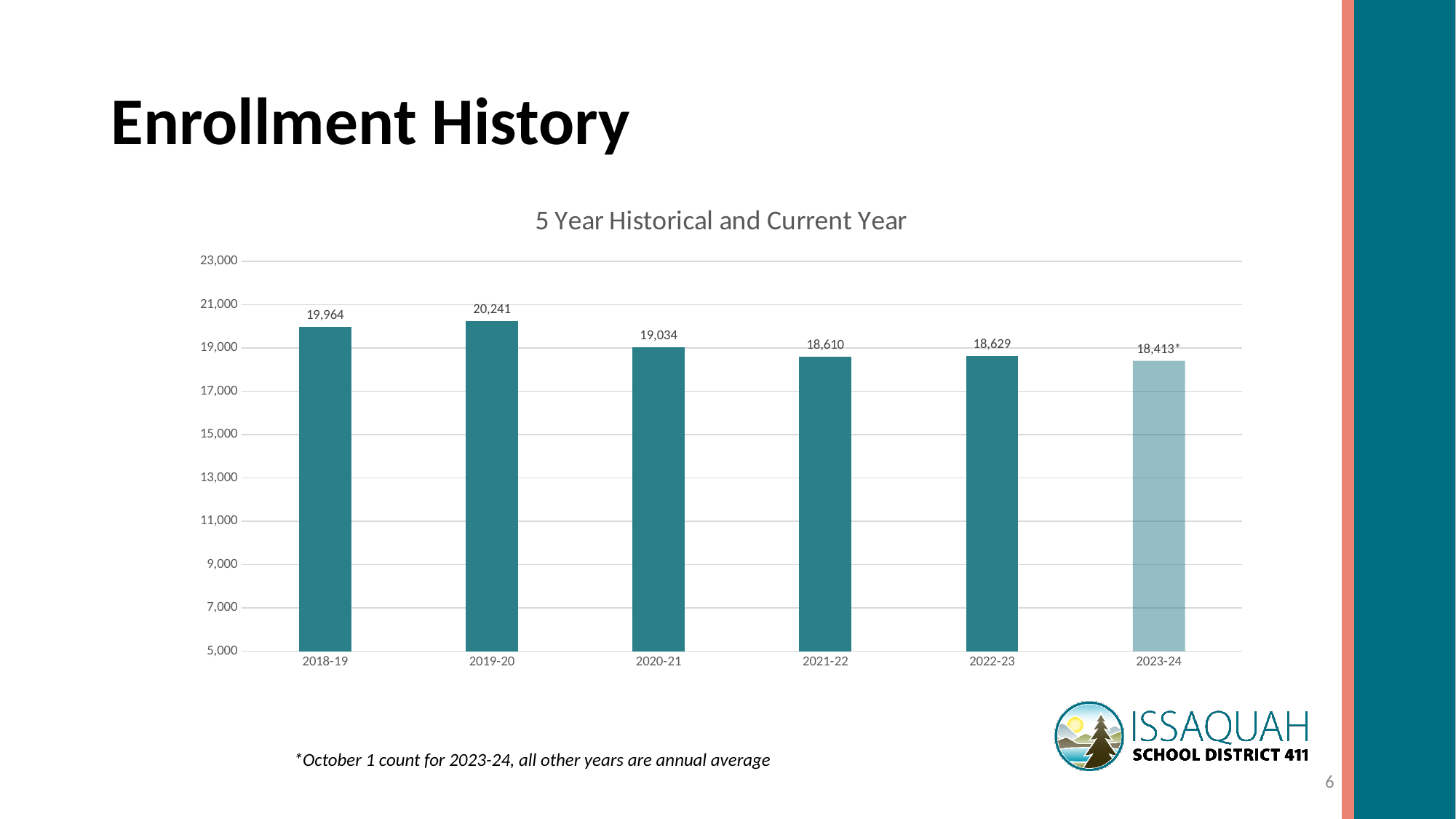
Which is larger, the enrollment for 2018-19 or for 2020-21? 2018-19 How many years are shown on the chart? 6 What is the enrollment value for 2021-22? 18,610 What is the difference in enrollment between 2020-21 and 2021-22? 424 What is the difference in enrollment between 2019-20 and 2018-19? 277 Is the value for 2020-21 greater or less than 17,000? greater Which year has the lowest enrollment? 2023-24 Which year has the highest enrollment? 2019-20 What kind of chart is shown on the slide? Bar chart What is the enrollment value for 2019-20? 20,241 What is the enrollment value shown for 2023-24? 18,413* What is the title of the chart? 5 Year Historical and Current Year